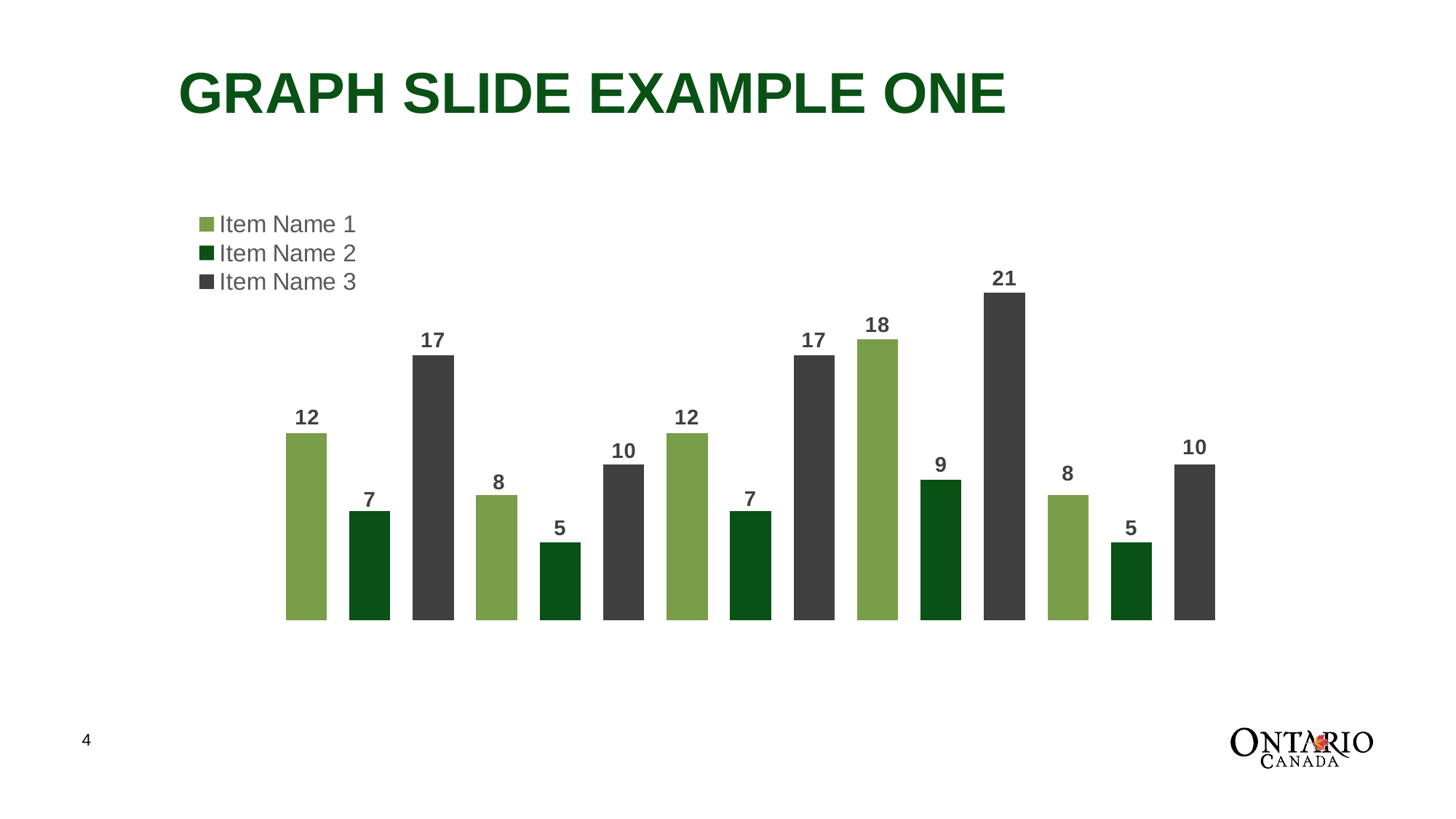
What is the value of Item Name 3 in the first group of bars from the left? 17 What is the difference between the Item Name 1 value in the first group and the Item Name 1 value in the second group? 4 What is the highest value shown in the chart? 21 What kind of chart is shown on the slide? bar chart How many series does the legend list? 3 What is the value of Item Name 1 in the fourth group of bars from the left? 18 What is the value of Item Name 2 in the second group of bars from the left? 5 In the fourth group of bars from the left, how much larger is Item Name 3 than Item Name 1? 3 What is the lowest value shown in the chart? 5 How many groups of bars are plotted in the chart? 5 In the second group of bars from the left, which is larger: Item Name 1 or Item Name 3? Item Name 3 What is the title of the slide containing the chart? GRAPH SLIDE EXAMPLE ONE